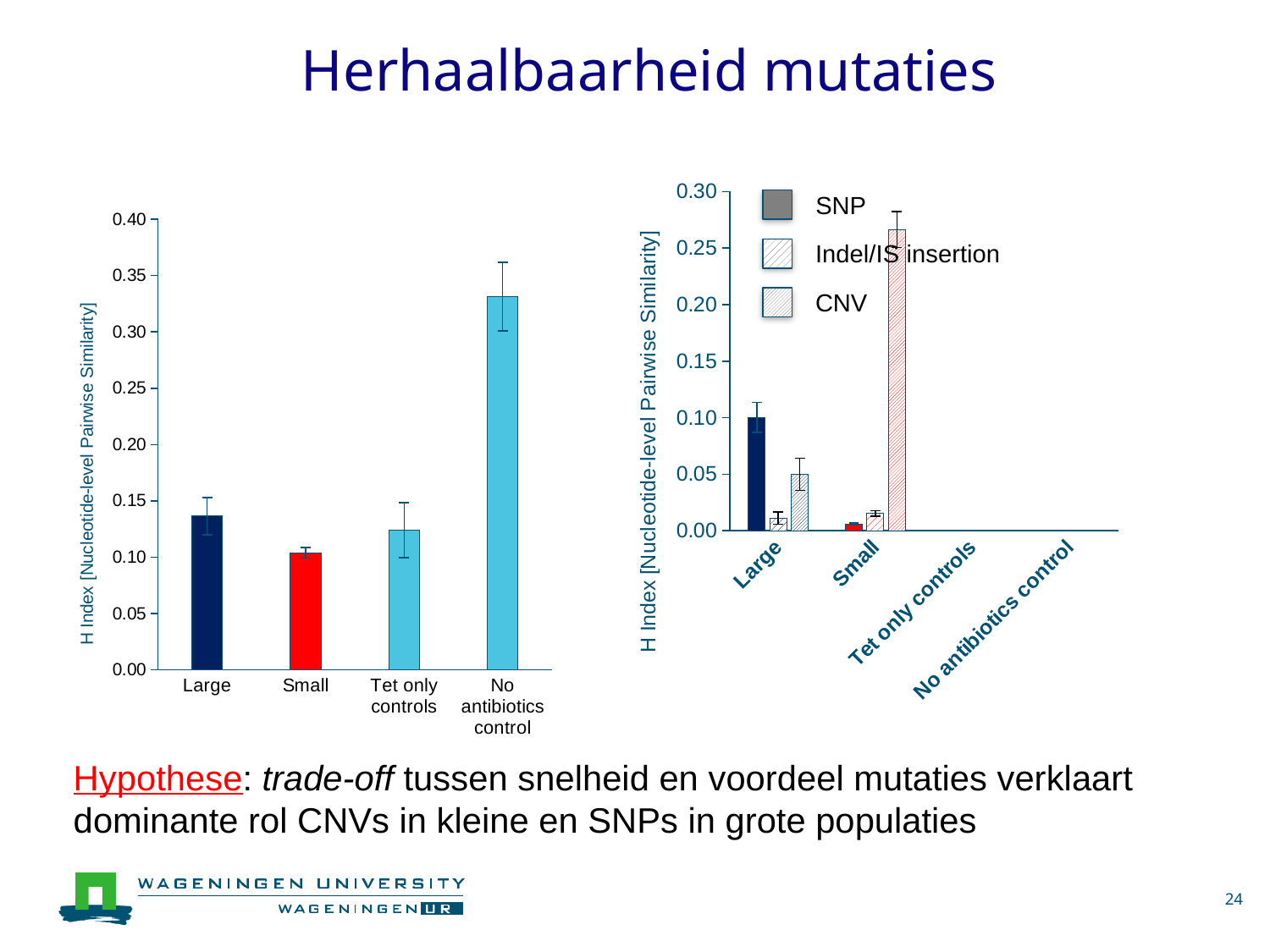
In the right chart, which series has the highest value for the Small category? CNV In the left chart, is the value for Small greater or less than 0.15? less In the right chart, which series has the highest value for the Large category? SNP What kind of chart is the left chart on the slide? bar chart In the left chart, which is larger: the value for No antibiotics control or the value for Large? No antibiotics control How many series does the legend of the right chart list? 3 In the left chart, which category has the highest H Index value? No antibiotics control How many categories are shown on the x axis of the left chart? 4 In the left chart, is the value for No antibiotics control greater or less than 0.30? greater In the left chart, which category has the lowest H Index value? Small What is the y-axis label of the right chart? H Index [Nucleotide-level Pairwise Similarity] In the right chart, is the CNV value for Small greater or less than 0.20? greater